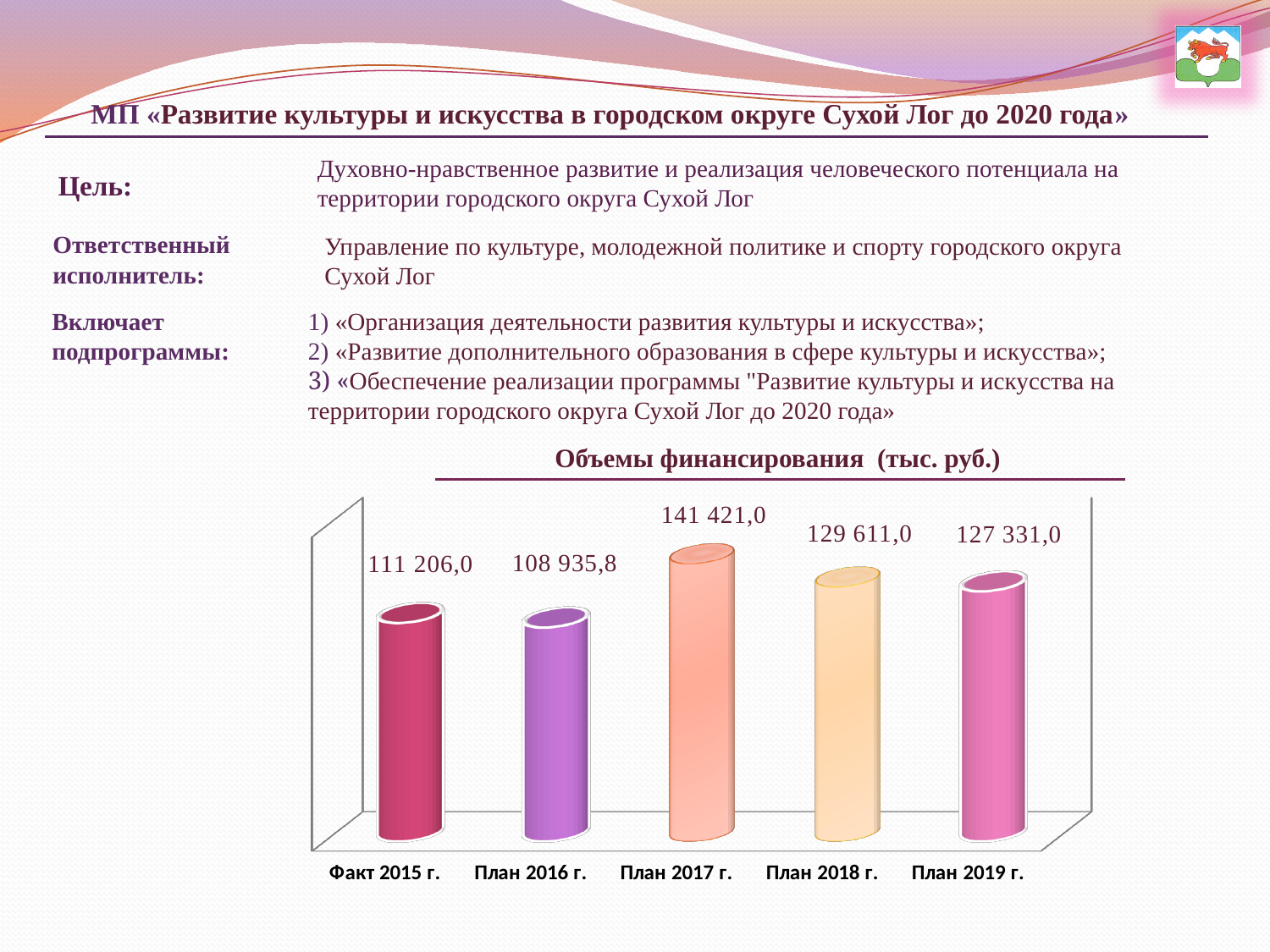
How many categories are shown on the chart? 5 Which category has the highest value? План 2017 г. What is the difference between the values for Факт 2015 г. and План 2016 г.? 2 270,2 What is the value for План 2017 г.? 141 421,0 Which is larger, the value for План 2018 г. or the value for План 2019 г.? План 2018 г. What is the value for Факт 2015 г.? 111 206,0 What is the value for План 2016 г.? 108 935,8 What kind of chart is shown on the slide? bar chart Which category has the lowest value? План 2016 г. What is the title of the chart? Объемы финансирования (тыс. руб.) What is the difference between the values for План 2017 г. and План 2018 г.? 11 810,0 What is the value for План 2019 г.? 127 331,0